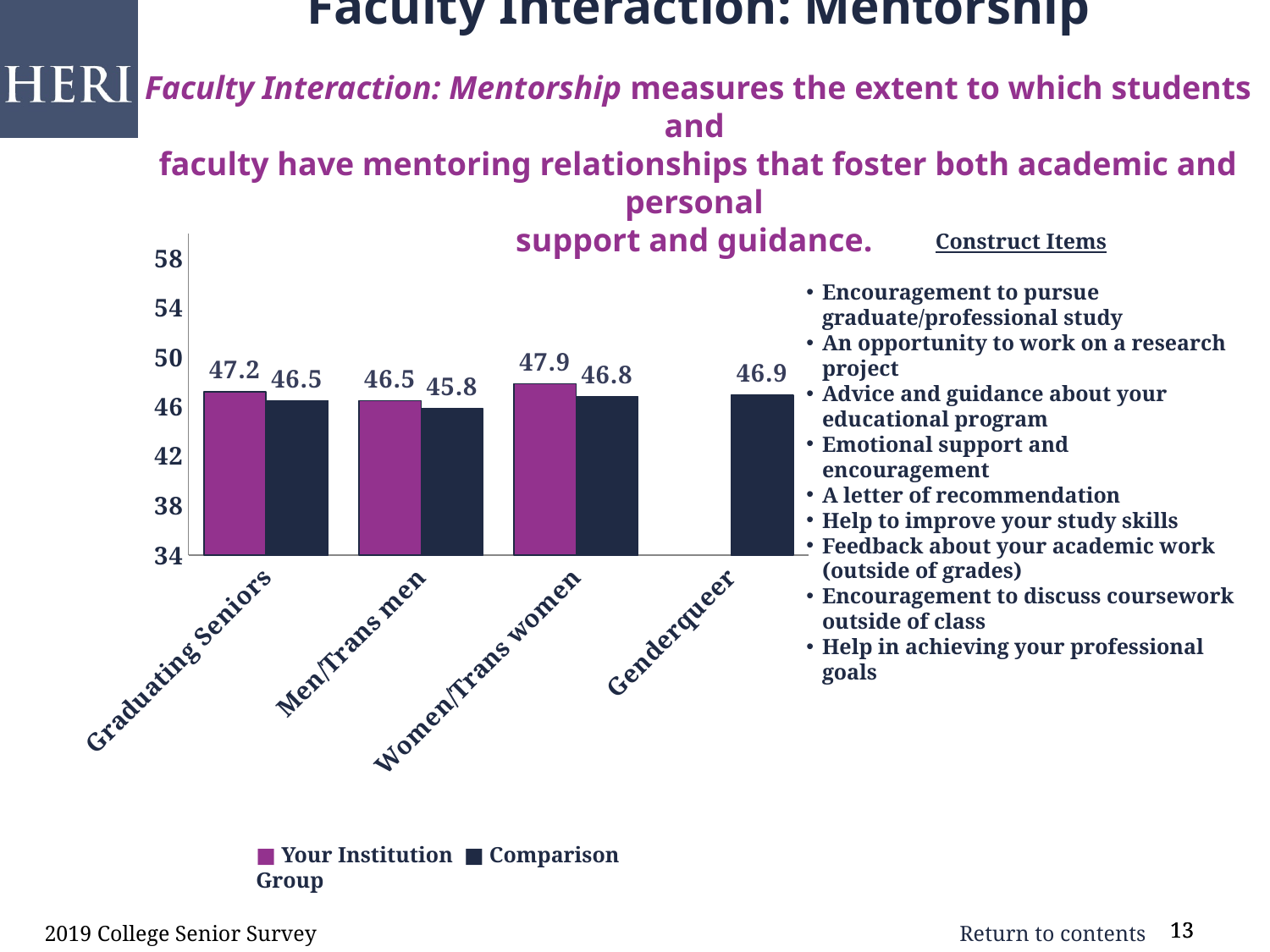
Which category has the lowest Comparison Group value? Men/Trans men What is the Comparison Group value for Men/Trans men? 45.8 How many categories are shown on the x axis? 4 Which is larger for Men/Trans men: the Your Institution value or the Comparison Group value? Your Institution Is the Comparison Group value for Graduating Seniors greater or less than 50? less Which category has no Your Institution bar? Genderqueer Which category has the highest Your Institution value? Women/Trans women What is the Comparison Group value for Genderqueer? 46.9 What kind of chart is shown on the slide? bar chart What is the difference between the Your Institution and Comparison Group values for Women/Trans women? 1.1 What is the Your Institution value for Graduating Seniors? 47.2 How many series does the legend list? 2